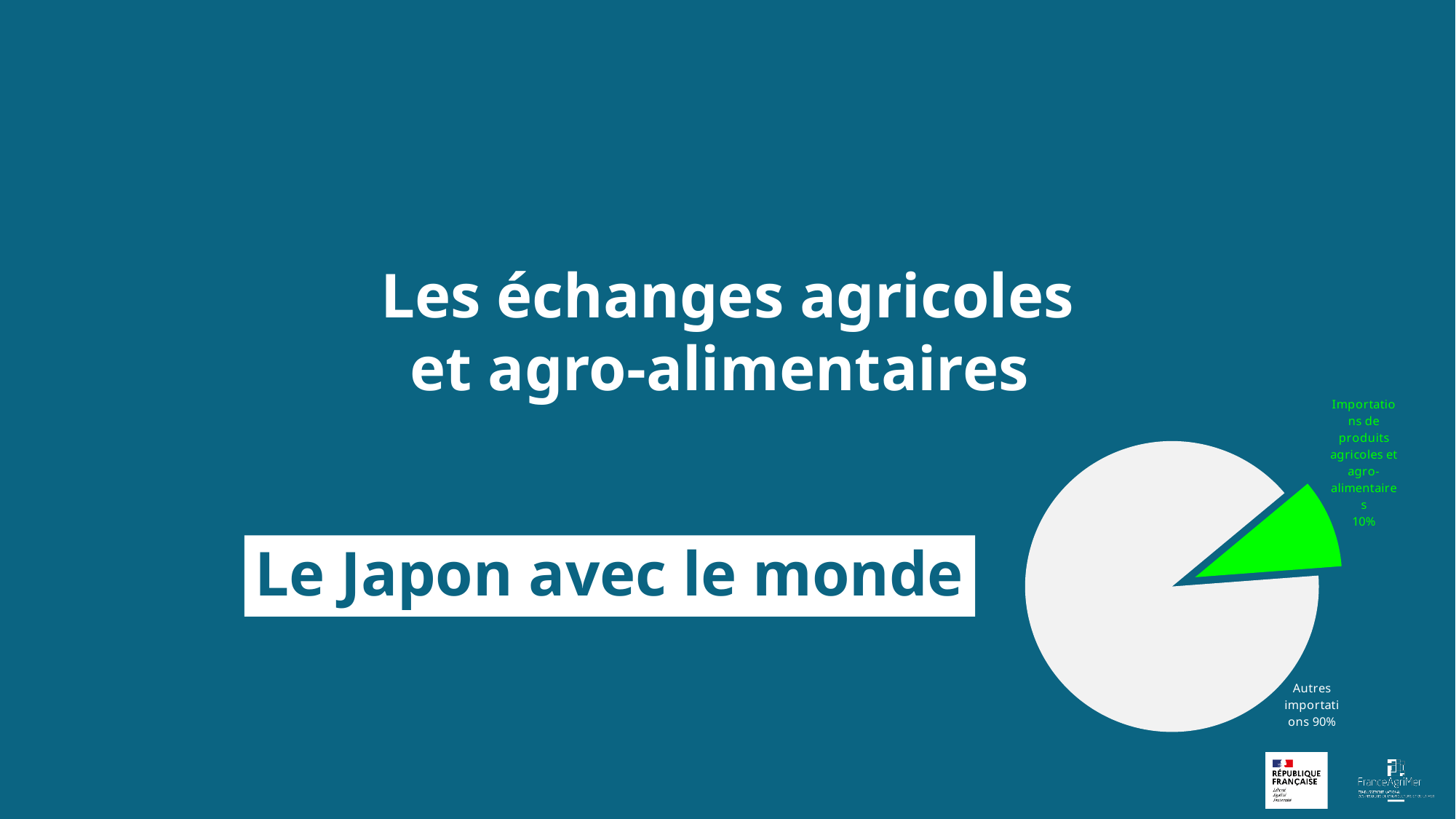
What share of the pie is labelled "Autres importations"? 90% Which slice of the pie chart is the smallest? Importations de produits agricoles et agro-alimentaires What colour is the "Importations de produits agricoles et agro-alimentaires" slice? green What is the difference in percentage points between the "Autres importations" slice and the "Importations de produits agricoles et agro-alimentaires" slice? 80 percentage points What kind of chart is shown on the slide? pie chart What colour is the "Autres importations" slice? white What share of the pie is labelled "Importations de produits agricoles et agro-alimentaires"? 10% Which is larger: the "Autres importations" slice or the "Importations de produits agricoles et agro-alimentaires" slice? Autres importations How many slices does the pie chart have? 2 Which slice of the pie chart is the largest? Autres importations